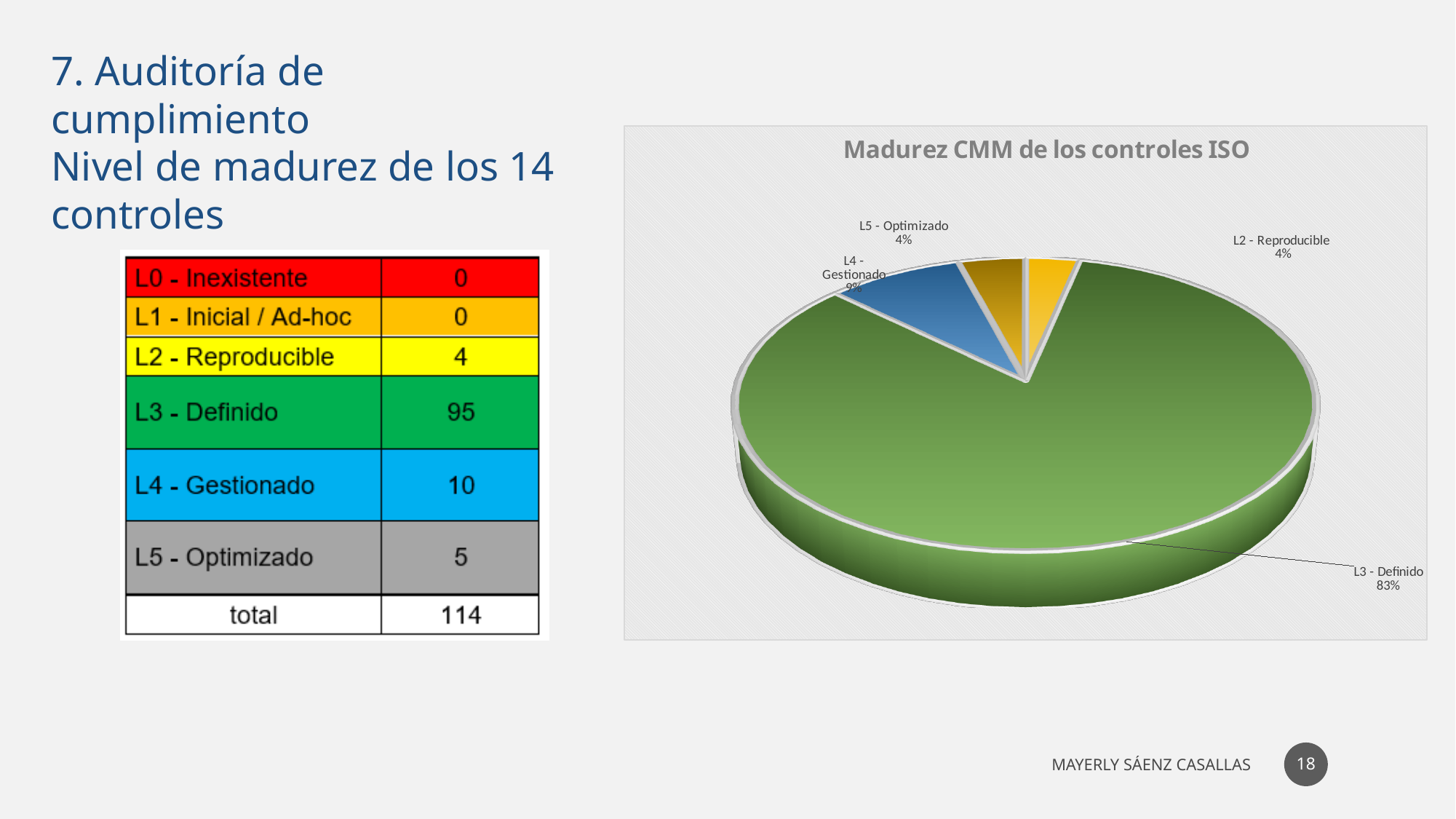
Which slice of the pie is the largest? L3 - Definido What share of the pie does L2 - Reproducible represent? 4% What is the title of the chart? Madurez CMM de los controles ISO What share of the pie does L3 - Definido represent? 83% What share of the pie does L4 - Gestionado represent? 9% Which is larger, the share for L4 - Gestionado or the share for L5 - Optimizado? L4 - Gestionado What kind of chart is shown on the slide? pie chart What colour is the L3 - Definido slice in the pie chart? green Is the share for L3 - Definido greater or less than 50%? greater What is the difference in percentage points between the L3 - Definido share and the L4 - Gestionado share? 74 How many slices are labelled in the pie chart? 4